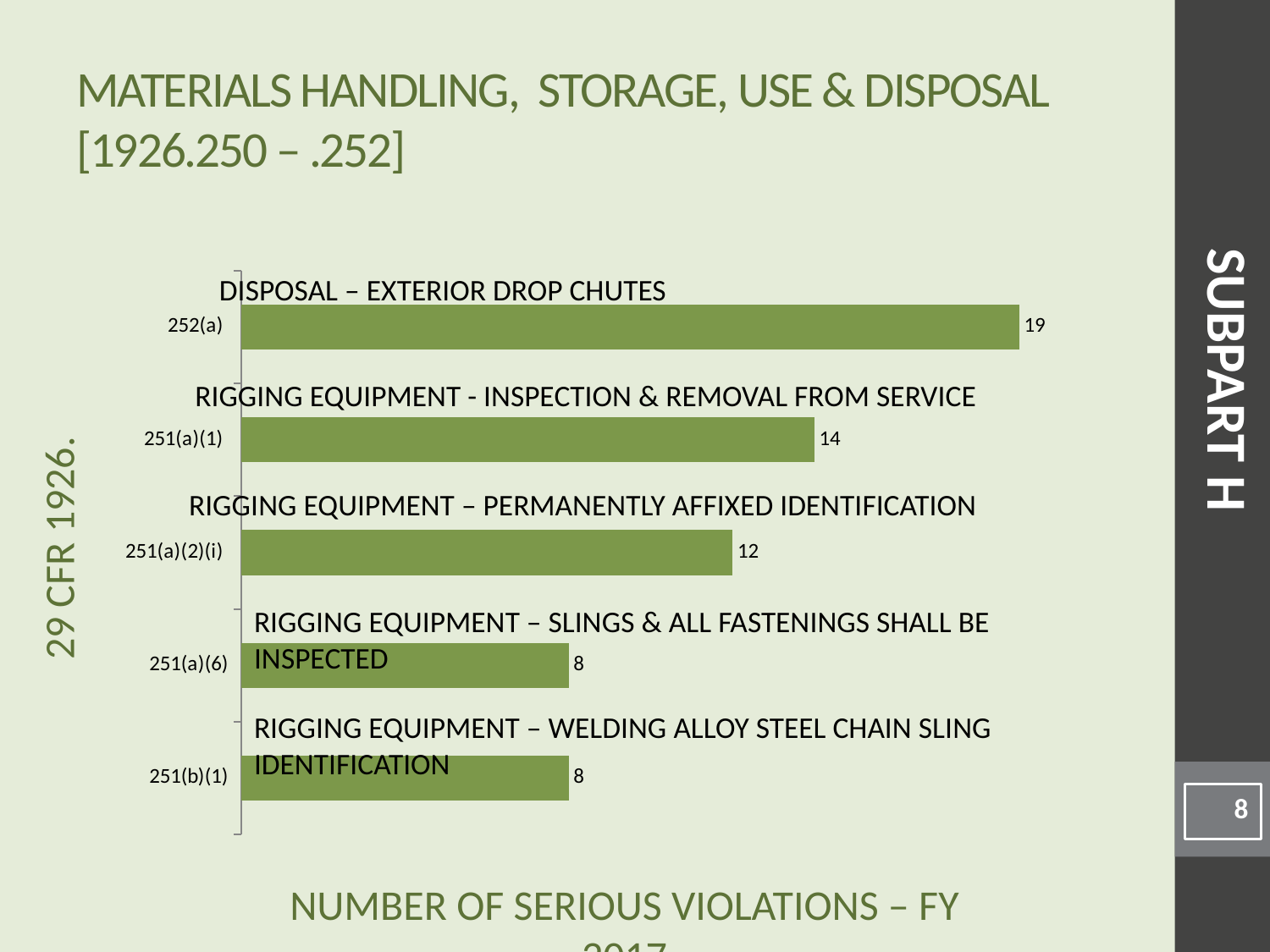
Which category has the highest number of serious violations? 252(a) What is the number of serious violations for 252(a)? 19 How many categories are shown in the chart? 5 What type of chart is shown on the slide? Bar chart What is the number of serious violations for 251(a)(6)? 8 Which standard is described as 'DISPOSAL – EXTERIOR DROP CHUTES'? 252(a) What is the difference in serious violations between 251(a)(2)(i) and 251(b)(1)? 4 What is the number of serious violations for 251(a)(2)(i)? 12 What is the difference in serious violations between 252(a) and 251(a)(1)? 5 What is the total number of serious violations across all five categories? 61 What is the number of serious violations for 251(a)(1)? 14 Which has more serious violations, 251(a)(1) or 251(a)(2)(i)? 251(a)(1)